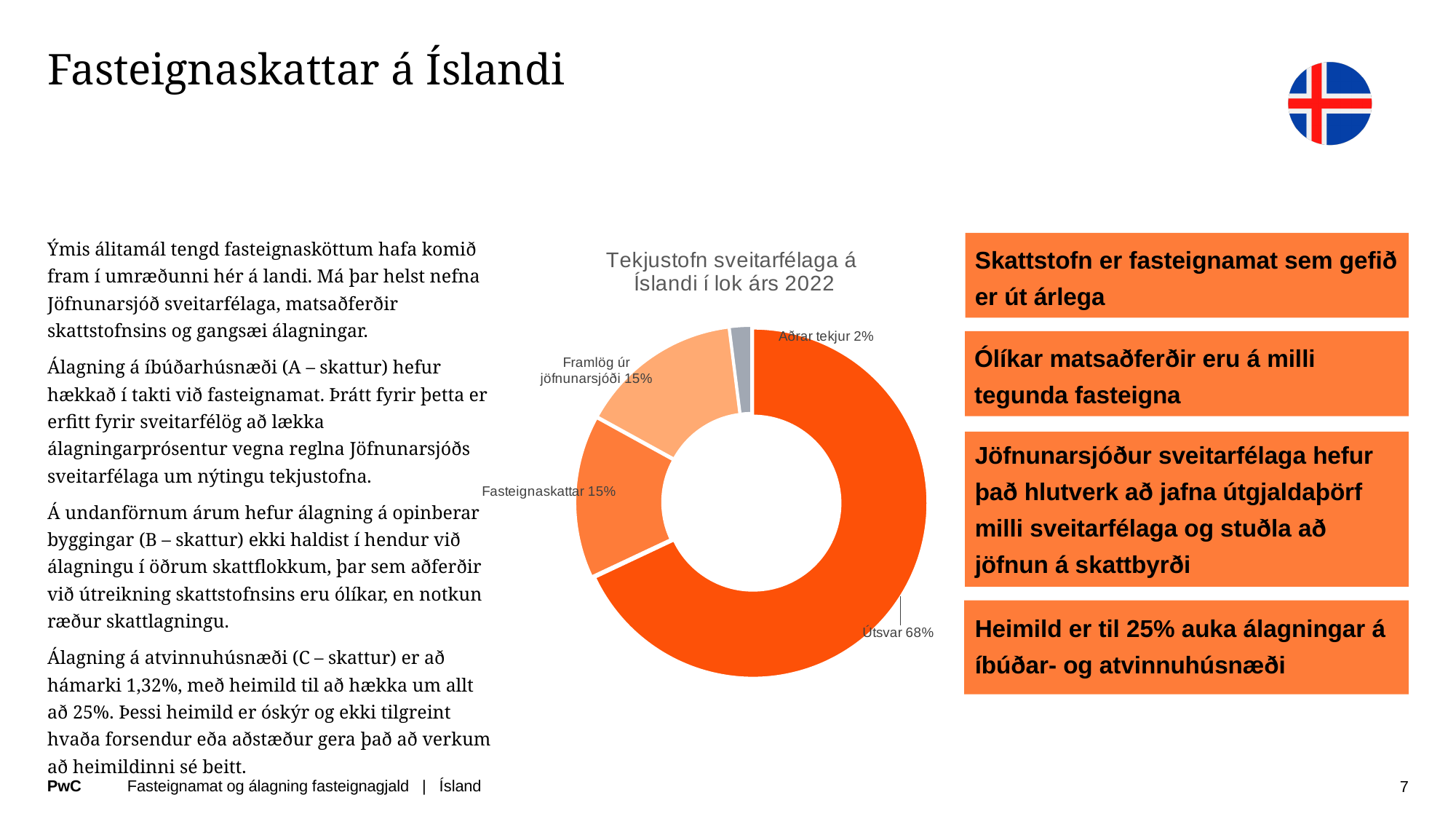
What share of the pie does Aðrar tekjur represent? 2% What is the difference in percentage points between Útsvar and Fasteignaskattar? 53 What share of the pie does Útsvar represent? 68% What is the combined share of Fasteignaskattar and Framlög úr jöfnunarsjóði? 30% How many slices does the pie chart have? 4 What share of the pie does Framlög úr jöfnunarsjóði represent? 15% What kind of chart is shown on the slide? Pie chart (donut) Which is larger, the share for Útsvar or the share for Aðrar tekjur? Útsvar Which category has the smallest slice of the pie? Aðrar tekjur What is the title of the chart? Tekjustofn sveitarfélaga á Íslandi í lok árs 2022 Which category has the largest slice of the pie? Útsvar